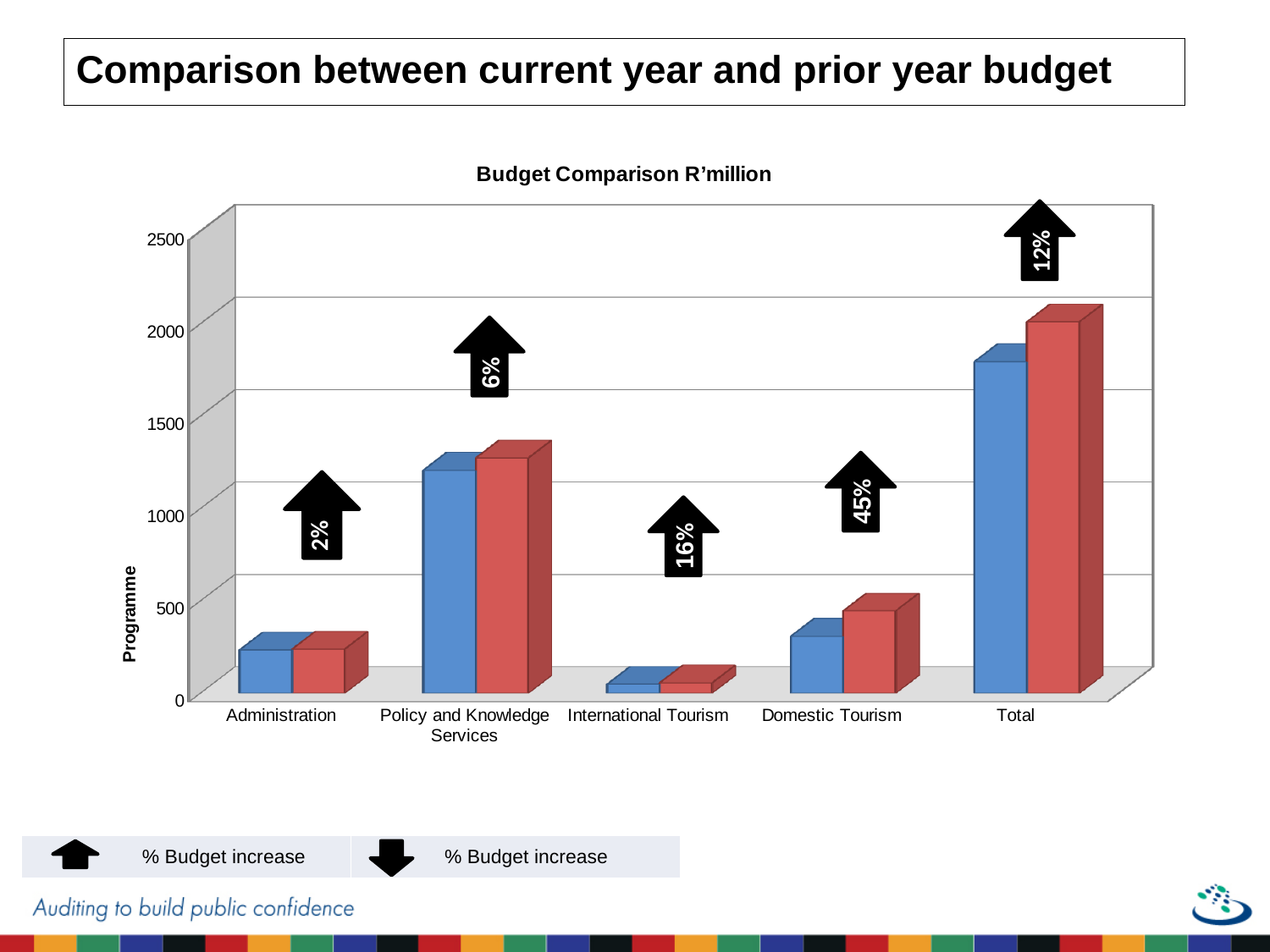
What percentage budget increase is shown for Policy and Knowledge Services? 6% Is the value of the blue bar for Total greater or less than 1500? greater Is the value of the blue bar for Administration greater or less than 500? less What type of chart is shown on the slide? bar chart What percentage budget increase is shown for Administration? 2% What percentage budget increase is shown for Total? 12% What percentage budget increase is shown for Domestic Tourism? 45% How many programme categories are shown on the x axis of the chart? 5 What is the title of the chart? Budget Comparison R’million What percentage budget increase is shown for International Tourism? 16% Which category has the highest percentage budget increase? Domestic Tourism Which category has the lowest percentage budget increase? Administration